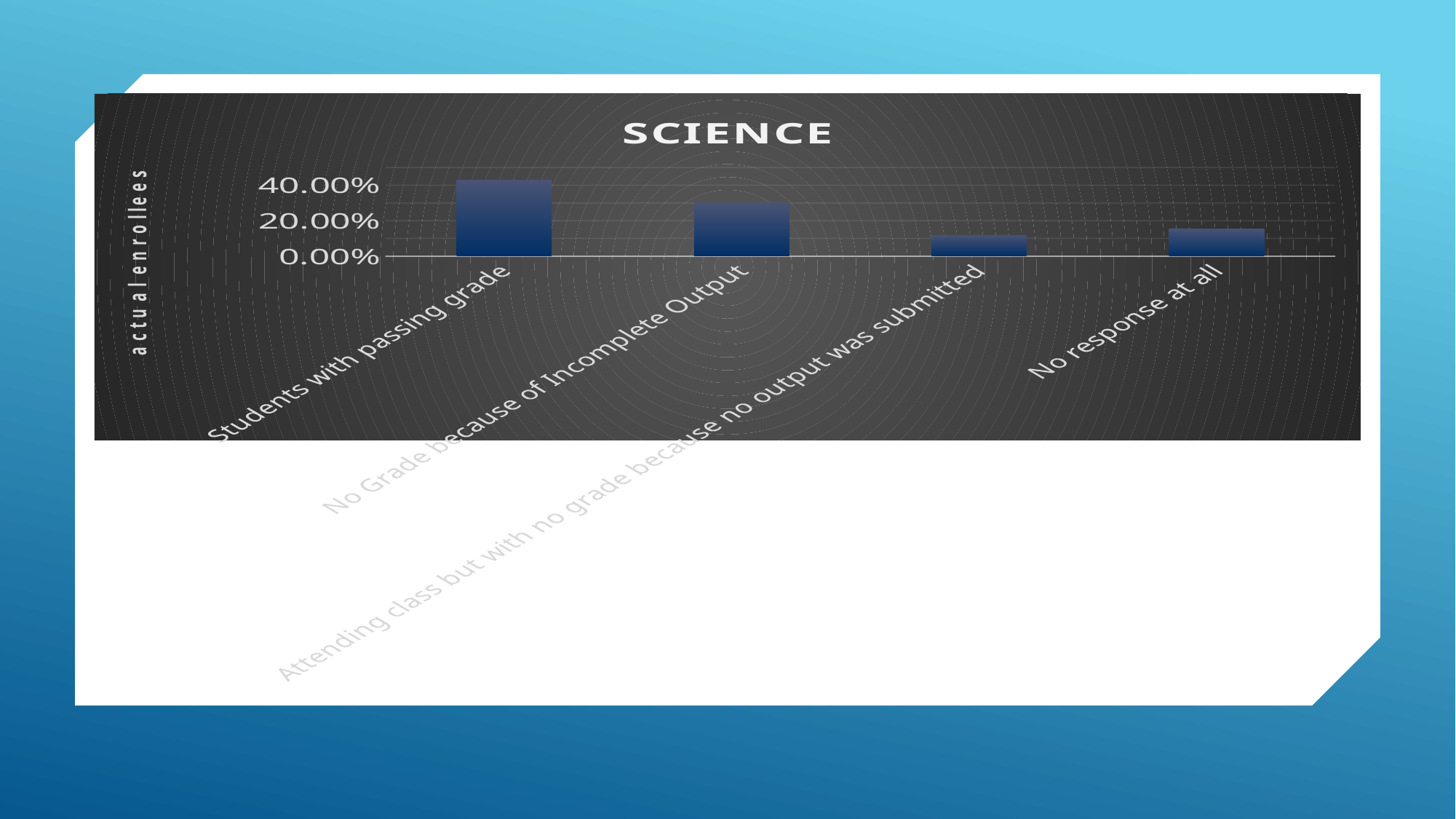
Is the value for No response at all greater or less than 20.00%? less Is the value for Attending class but with no grade because no output was submitted greater or less than 20.00%? less Which category has the lowest value in the chart? Attending class but with no grade because no output was submitted How many categories are shown on the x axis of the chart? 4 What is the label of the vertical axis of the chart? actual enrollees Is the value for No Grade because of Incomplete Output greater or less than 20.00%? greater What is the title of the chart? SCIENCE Which category has the highest value in the chart? Students with passing grade What kind of chart is shown on the slide? bar chart Which is larger: the value for Students with passing grade or the value for No Grade because of Incomplete Output? Students with passing grade